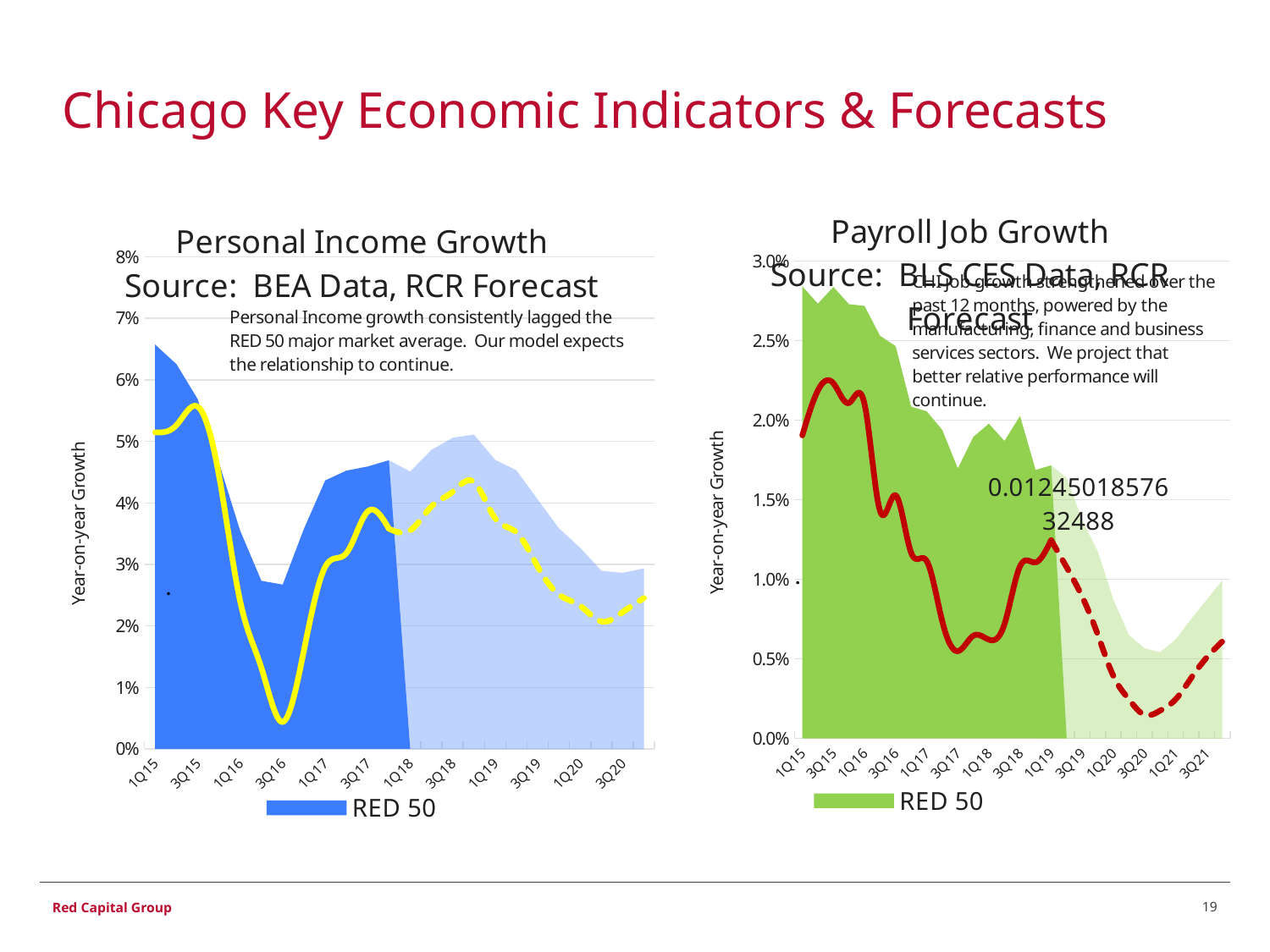
In the Payroll Job Growth chart, is the RED 50 shaded area value at 1Q15 greater or less than 2.5%? greater In the Personal Income Growth chart, is the RED 50 shaded area value at 1Q15 greater or less than 6%? greater In the Payroll Job Growth chart, does the red line rise or fall from 3Q15 to 3Q20? fall How many x-axis labels are shown on the Payroll Job Growth chart? 14 In the Payroll Job Growth chart, is the red line value at 3Q20 greater or less than 0.5%? less What kind of chart is the Personal Income Growth chart on the left? Area chart with a line overlay What is the y-axis label on the Personal Income Growth chart? Year-on-year Growth In the Personal Income Growth chart, does the RED 50 shaded area rise or fall from 1Q15 to 3Q16? fall How many series does the legend of the Payroll Job Growth chart list? 1